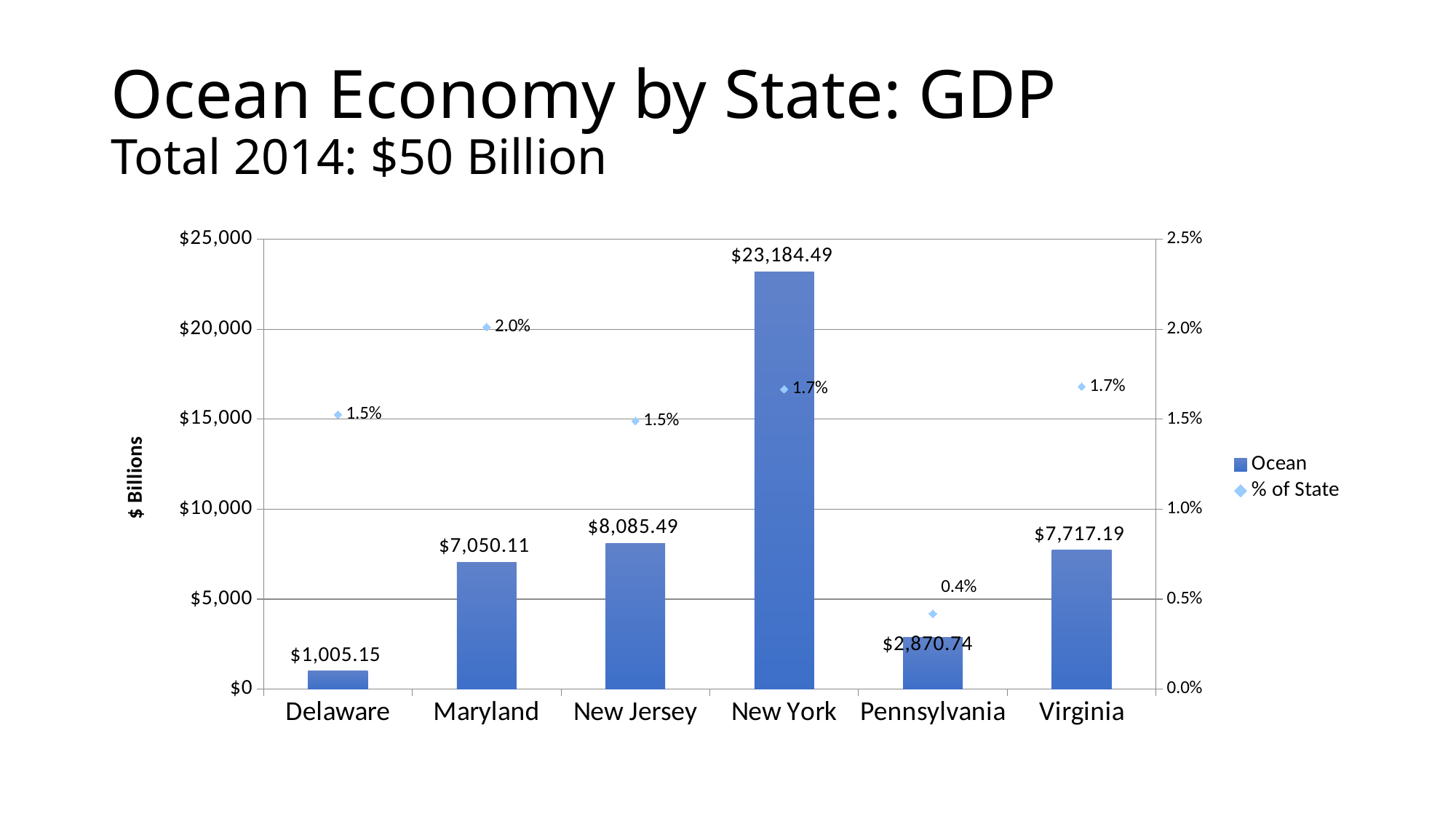
How many series does the legend list? 2 Which state has the lowest % of State value? Pennsylvania Which state has the lowest Ocean GDP value? Delaware How many states are shown on the x axis? 6 What is the Ocean GDP value shown for Delaware? $1,005.15 What is the label of the left vertical axis? $ Billions Which has a larger Ocean GDP value, Virginia or Maryland? Virginia What % of State value is shown for Pennsylvania? 0.4% Which state has the highest Ocean GDP value? New York What % of State value is shown for Maryland? 2.0% What is the difference between the Ocean GDP values for New Jersey and Maryland? $1,035.38 What is the Ocean GDP value shown for New York? $23,184.49